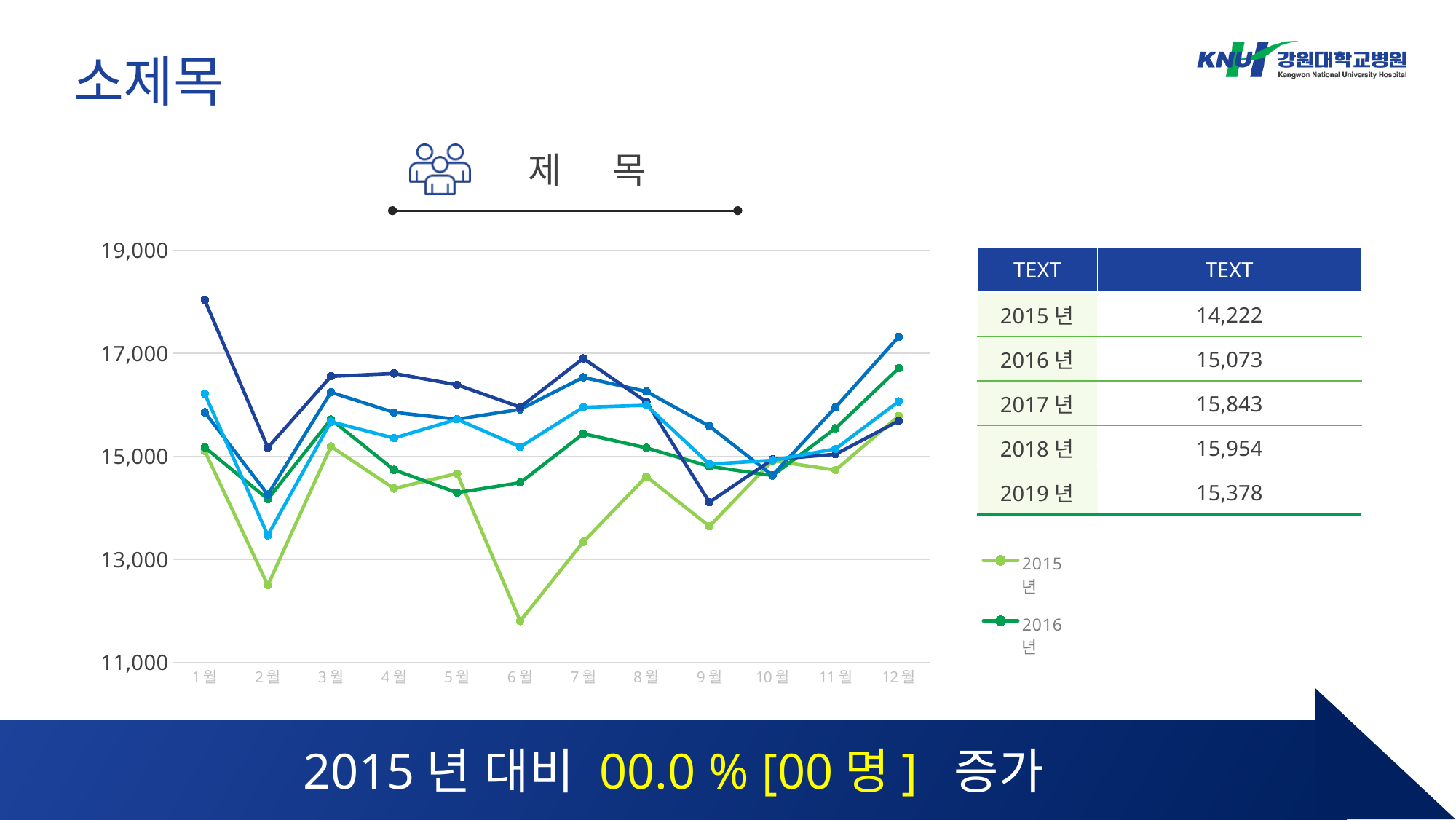
Does the 2015년 series rise or fall from 9월 to 12월? rise What kind of chart is shown on the slide? line chart What is the highest value labelled on the chart's y axis? 19,000 Is the value for 2016년 in 12월 greater or less than 15,000? greater In which month is the 2015년 series at its lowest? 6월 In 6월, which series has the larger value, 2015년 or 2016년? 2016년 Is the value for 2015년 in 6월 greater or less than 13,000? less In which month is the 2016년 series at its highest? 12월 How many series does the chart's legend list? 2 Is the value for 2016년 in 2월 greater or less than 15,000? less How many months are shown along the x axis of the chart? 12